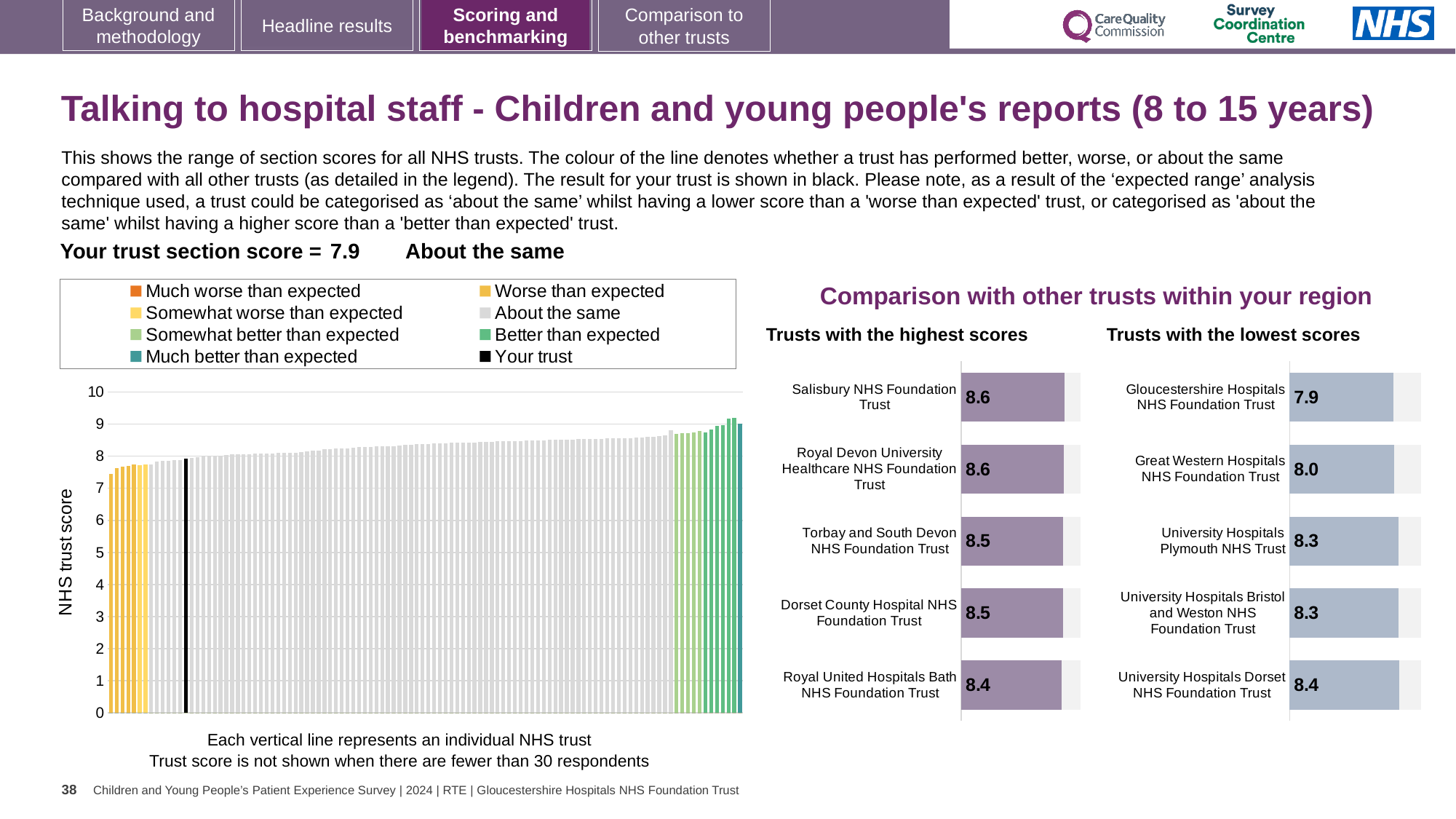
In the 'Trusts with the highest scores' chart, which trust has the lowest score? Royal United Hospitals Bath NHS Foundation Trust In the 'Trusts with the lowest scores' chart, which has the higher score: Great Western Hospitals NHS Foundation Trust or University Hospitals Plymouth NHS Trust? University Hospitals Plymouth NHS Trust In the large chart on the left, is the value for the lowest-scoring (leftmost) trust greater or less than 8? less In the 'Trusts with the lowest scores' chart, what is the difference between the scores of University Hospitals Dorset NHS Foundation Trust and Gloucestershire Hospitals NHS Foundation Trust? 0.5 In the 'Trusts with the highest scores' chart, what is the score for Salisbury NHS Foundation Trust? 8.6 In the 'Trusts with the highest scores' chart, what is the difference between the scores of Salisbury NHS Foundation Trust and Royal United Hospitals Bath NHS Foundation Trust? 0.2 How many entries does the legend of the large chart on the left list? 8 In the 'Trusts with the lowest scores' chart, which trust has the lowest score? Gloucestershire Hospitals NHS Foundation Trust How many trusts are shown in the 'Trusts with the highest scores' chart? 5 What kind of chart is the large chart on the left showing NHS trust scores? Bar chart In the 'Trusts with the highest scores' chart, what is the score for Royal United Hospitals Bath NHS Foundation Trust? 8.4 In the 'Trusts with the lowest scores' chart, what is the score for Great Western Hospitals NHS Foundation Trust? 8.0